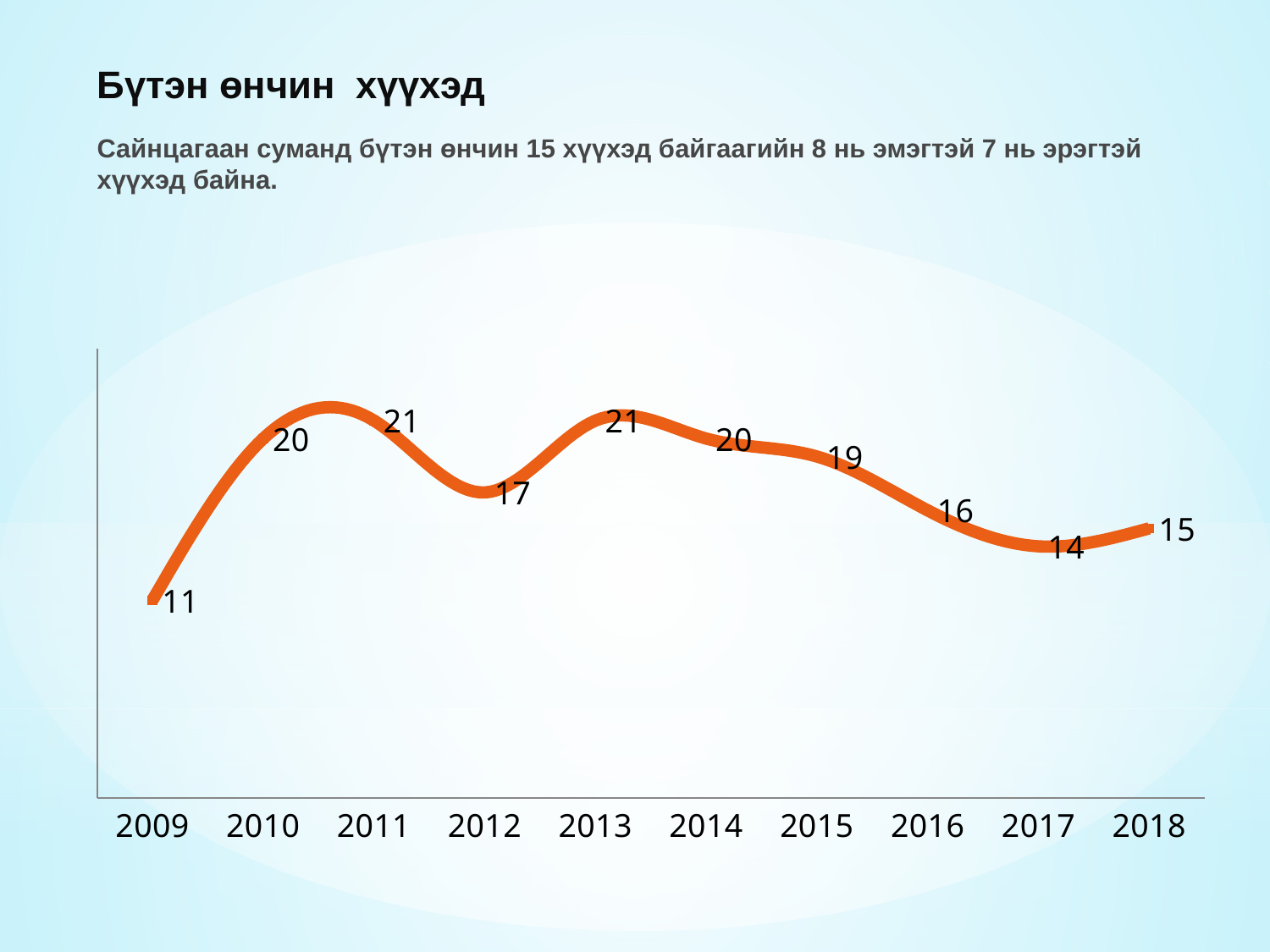
What type of chart is shown on the slide? line chart What is the difference between the values for 2013 and 2017? 7 What is the value for 2012? 17 What is the highest value plotted on the chart? 21 What is the value for 2009? 11 What is the value for 2018? 15 How many years are plotted on the x axis? 10 What is the difference between the values for 2010 and 2009? 9 Do the values rise or fall from 2013 to 2017? fall Which year has the lowest value? 2009 Which is larger, the value for 2014 or the value for 2016? 2014 What is the value for 2015? 19